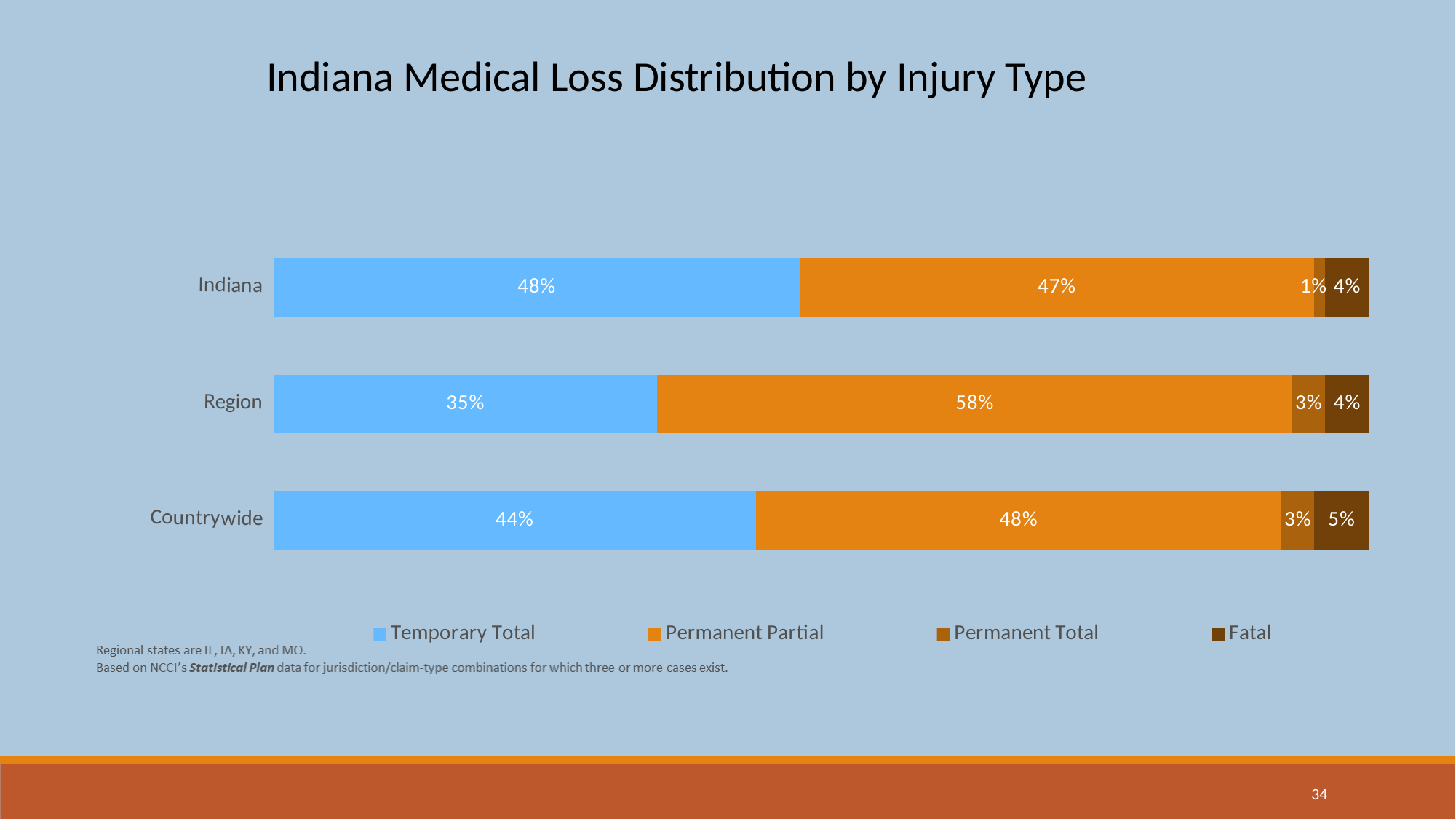
How many series does the legend list? 4 What is the Temporary Total share for Indiana? 48% Which category has the lowest Temporary Total share? Region How many categories are shown on the chart? 3 What is the Permanent Total share for Indiana? 1% What is the title of the chart? Indiana Medical Loss Distribution by Injury Type Which category has the highest Permanent Partial share? Region What is the difference between the Temporary Total shares for Indiana and Region? 13% What is the Permanent Partial share for Region? 58% Which is larger, the Permanent Partial share for Indiana or for Countrywide? Countrywide What is the Fatal share for Countrywide? 5% What kind of chart is shown on the slide? Stacked bar chart